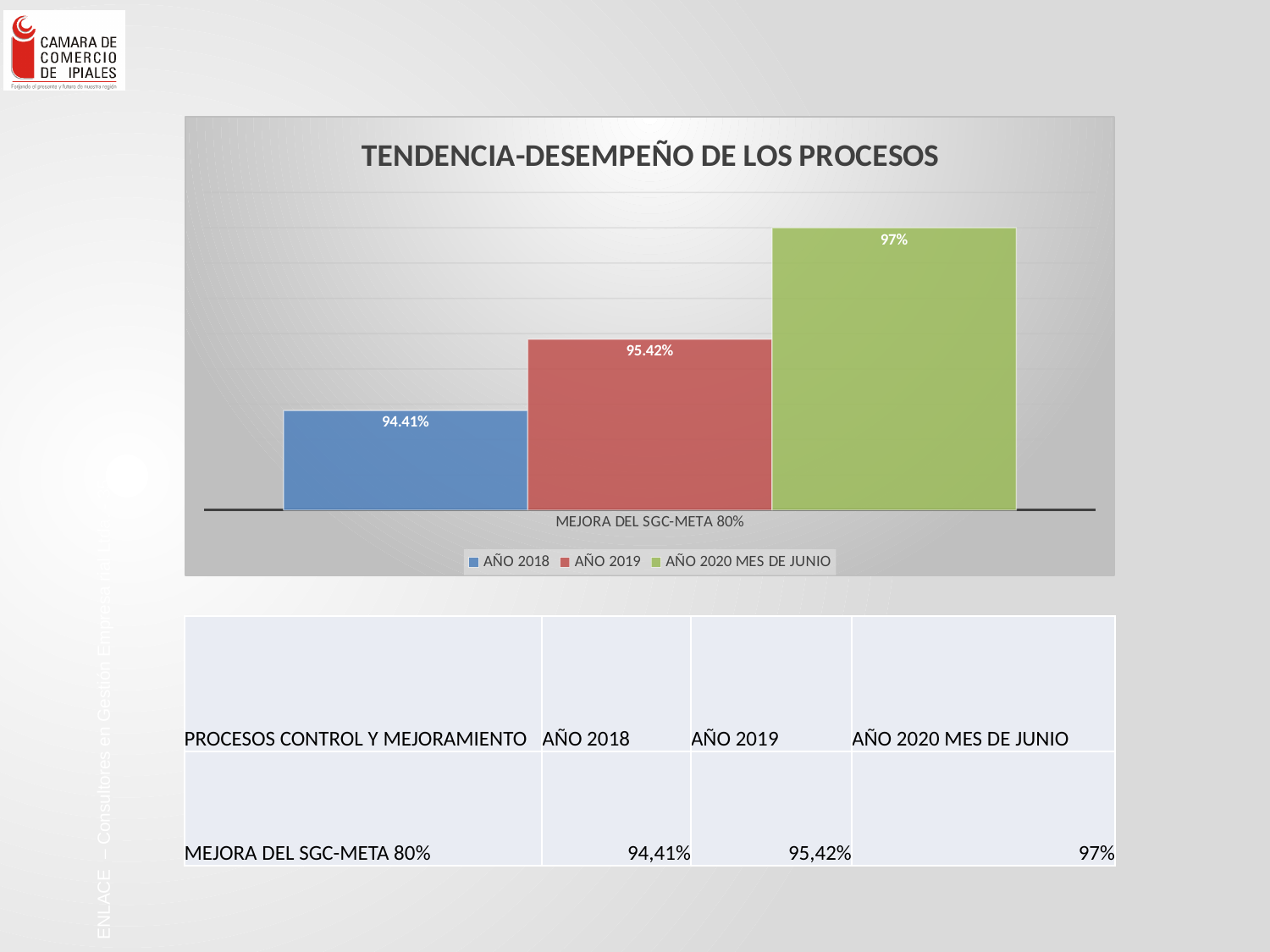
What kind of chart is shown on the slide? Bar chart What is the difference between the AÑO 2019 value and the AÑO 2018 value? 1.01% Do the values rise or fall from AÑO 2018 to AÑO 2020 MES DE JUNIO? Rise Which series has the highest value in the chart? AÑO 2020 MES DE JUNIO What is the value for AÑO 2019 in the chart? 95.42% What is the title of the chart? TENDENCIA-DESEMPEÑO DE LOS PROCESOS What is the difference between the AÑO 2020 MES DE JUNIO value and the AÑO 2018 value? 2.59% How many series does the legend list? 3 Which series has the lowest value in the chart? AÑO 2018 What is the value for AÑO 2018 in the chart? 94.41% Which is larger, the value for AÑO 2019 or the value for AÑO 2020 MES DE JUNIO? AÑO 2020 MES DE JUNIO What is the value for AÑO 2020 MES DE JUNIO in the chart? 97%